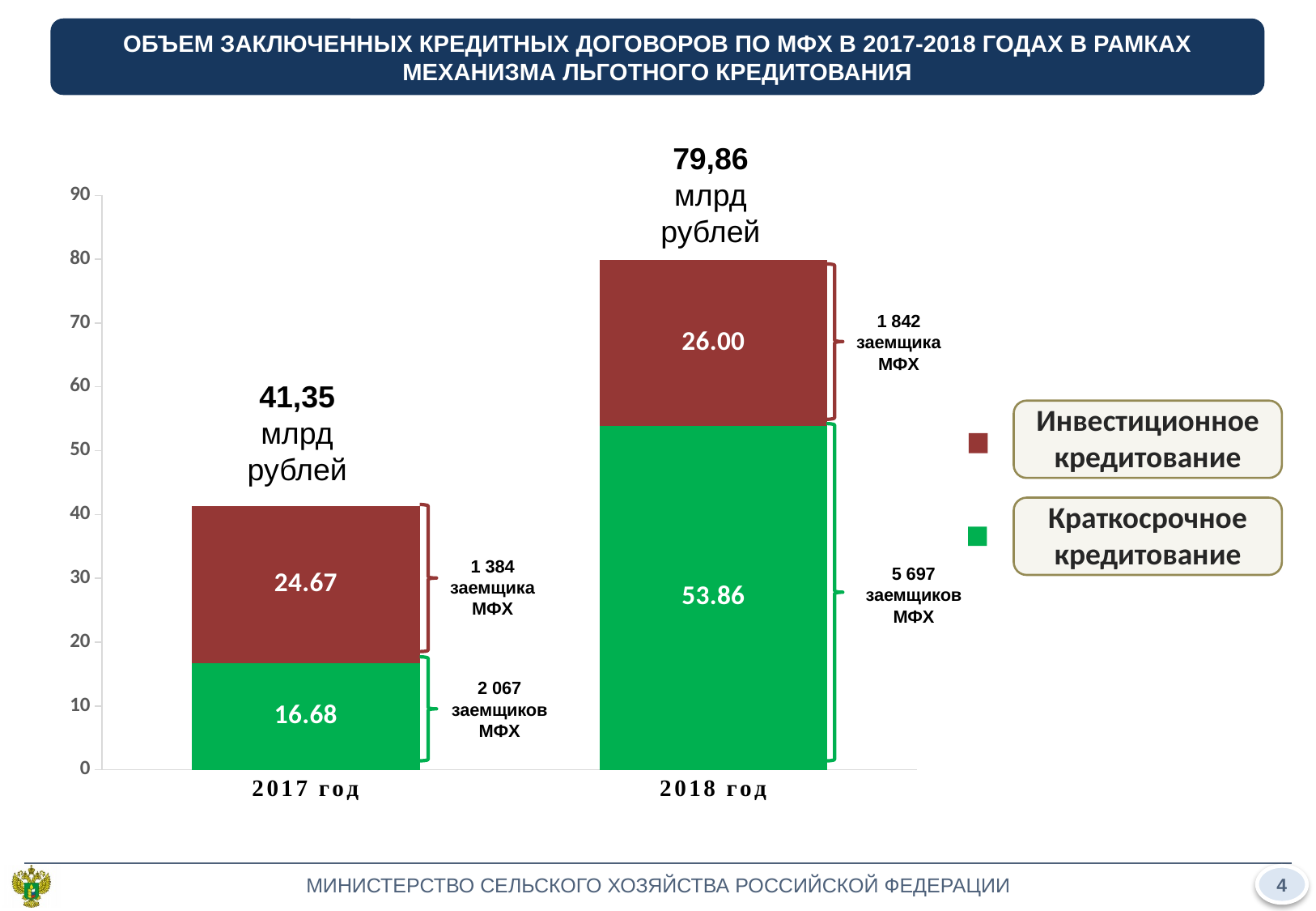
Is the total for 2018 год greater or less than 70? greater What is the total of the stacked bar for 2017 год, as labelled on the slide? 41,35 млрд рублей What is the value of Инвестиционное кредитование for 2017 год? 24.67 What kind of chart is shown on the slide? stacked bar chart What is the value of Краткосрочное кредитование for 2017 год? 16.68 What is the difference between the Краткосрочное кредитование values for 2018 год and 2017 год? 37.18 What is the total of the stacked bar for 2018 год, as labelled on the slide? 79,86 млрд рублей What is the value of Инвестиционное кредитование for 2018 год? 26.00 How many borrowers (заемщиков МФХ) are annotated for Краткосрочное кредитование in 2018 год? 5 697 How many categories are shown on the x axis? 2 Which year has the higher value for Краткосрочное кредитование? 2018 год How many series does the legend list? 2